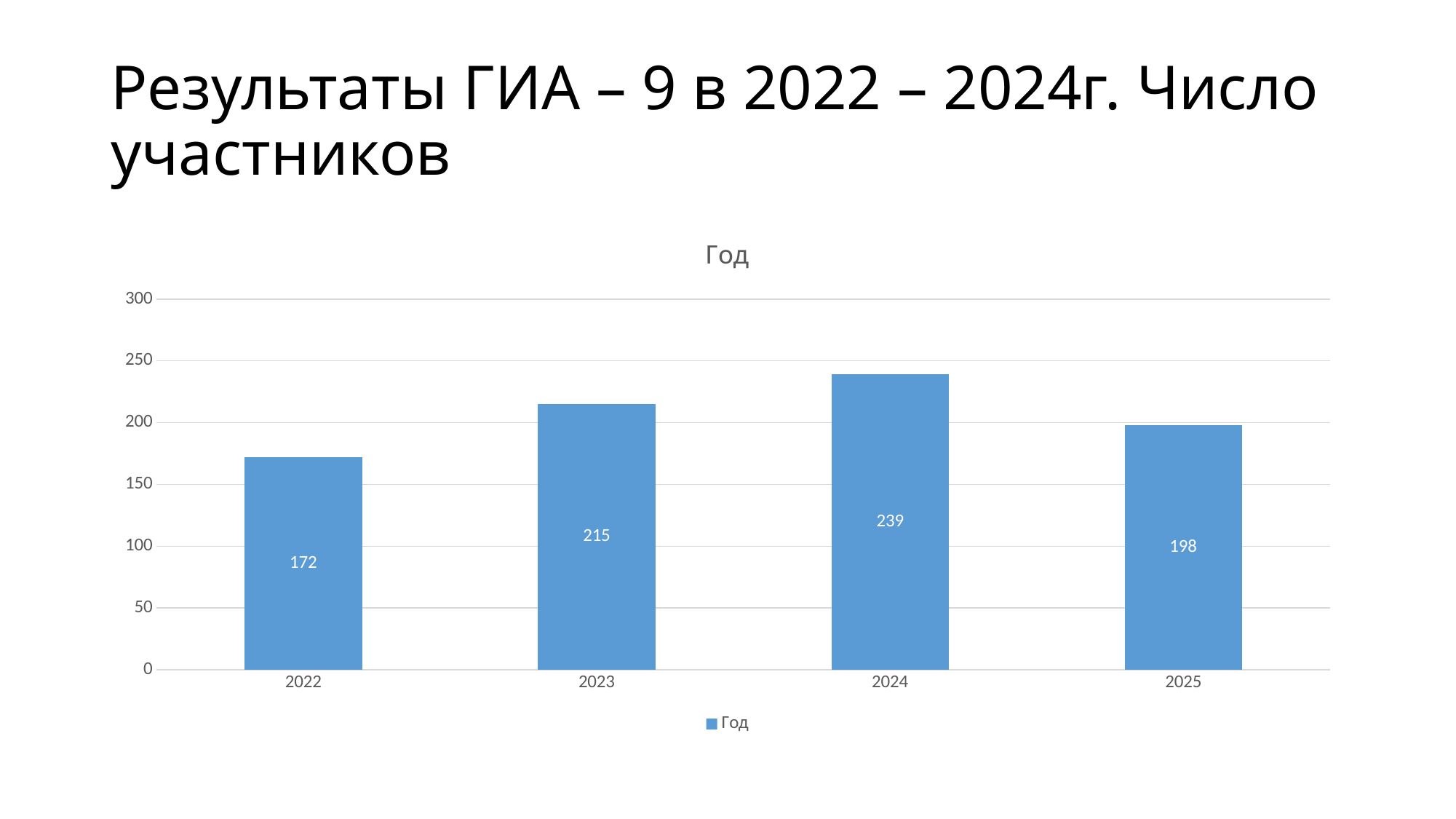
How many years are shown on the x axis? 4 Which year has the highest value? 2024 What is the value for 2025? 198 What is the difference between the values for 2023 and 2025? 17 What is the value for 2022? 172 What is the title of the chart? Год What is the difference between the values for 2024 and 2022? 67 Which is larger, the value for 2023 or the value for 2025? 2023 What is the value for 2024? 239 Which year has the lowest value? 2022 Is the value for 2025 greater or less than 200? less What kind of chart is shown on the slide? bar chart